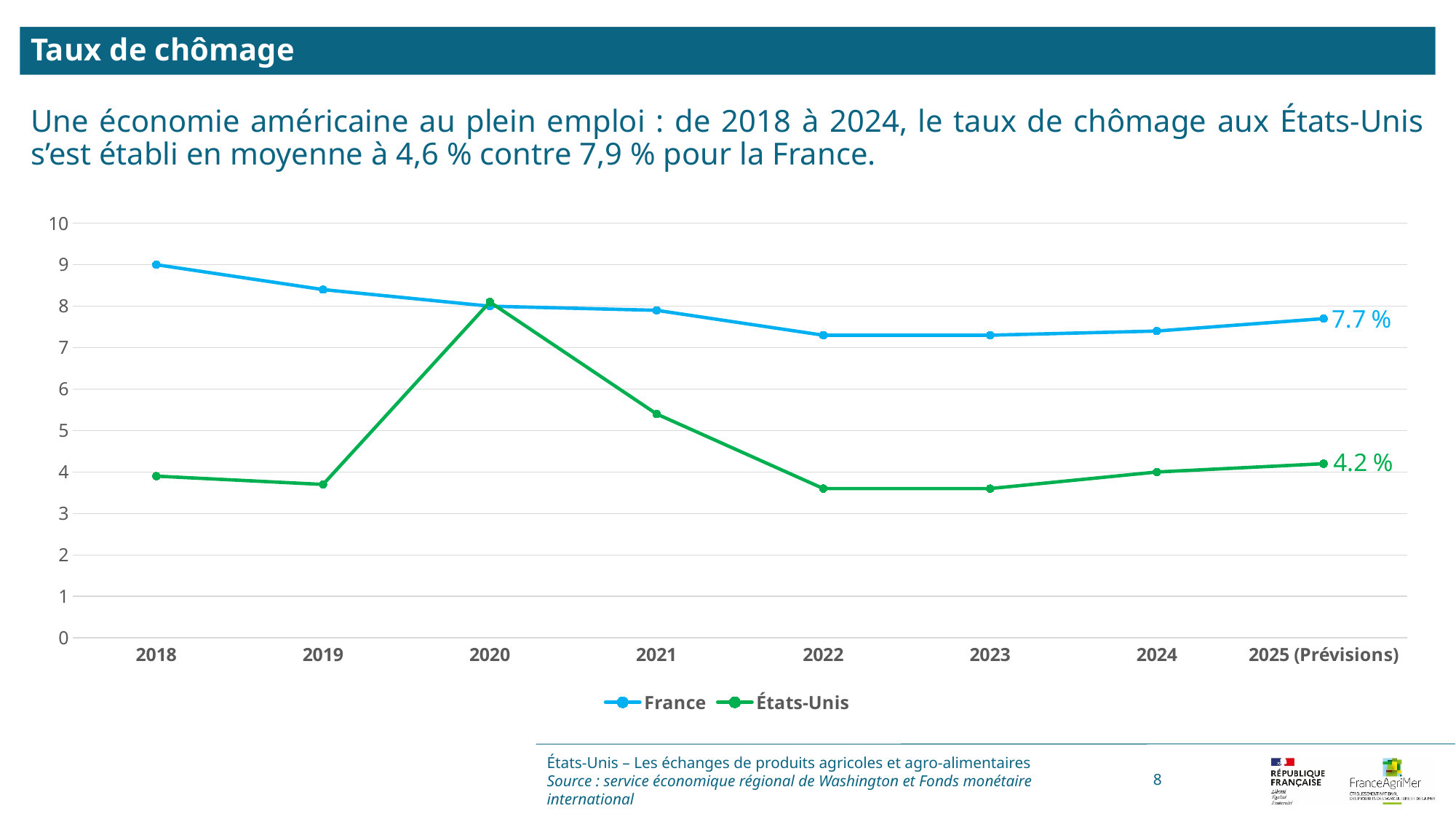
Is the value for États-Unis in 2022 greater or less than 4? less What is the value for France in 2025 (Prévisions)? 7.7 % What kind of chart is shown on the slide? line chart In 2025 (Prévisions), which series has the higher value, France or États-Unis? France What is the difference between the France and États-Unis values in 2025 (Prévisions)? 3.5 % Is the value for États-Unis in 2020 greater or less than 7? greater How many series does the legend list? 2 How many years (points) are plotted along the x axis? 8 What is the title of the slide containing the chart? Taux de chômage Does the France series rise or fall from 2018 to 2022? fall What is the value for États-Unis in 2025 (Prévisions)? 4.2 % In which year does the États-Unis series reach its highest value? 2020